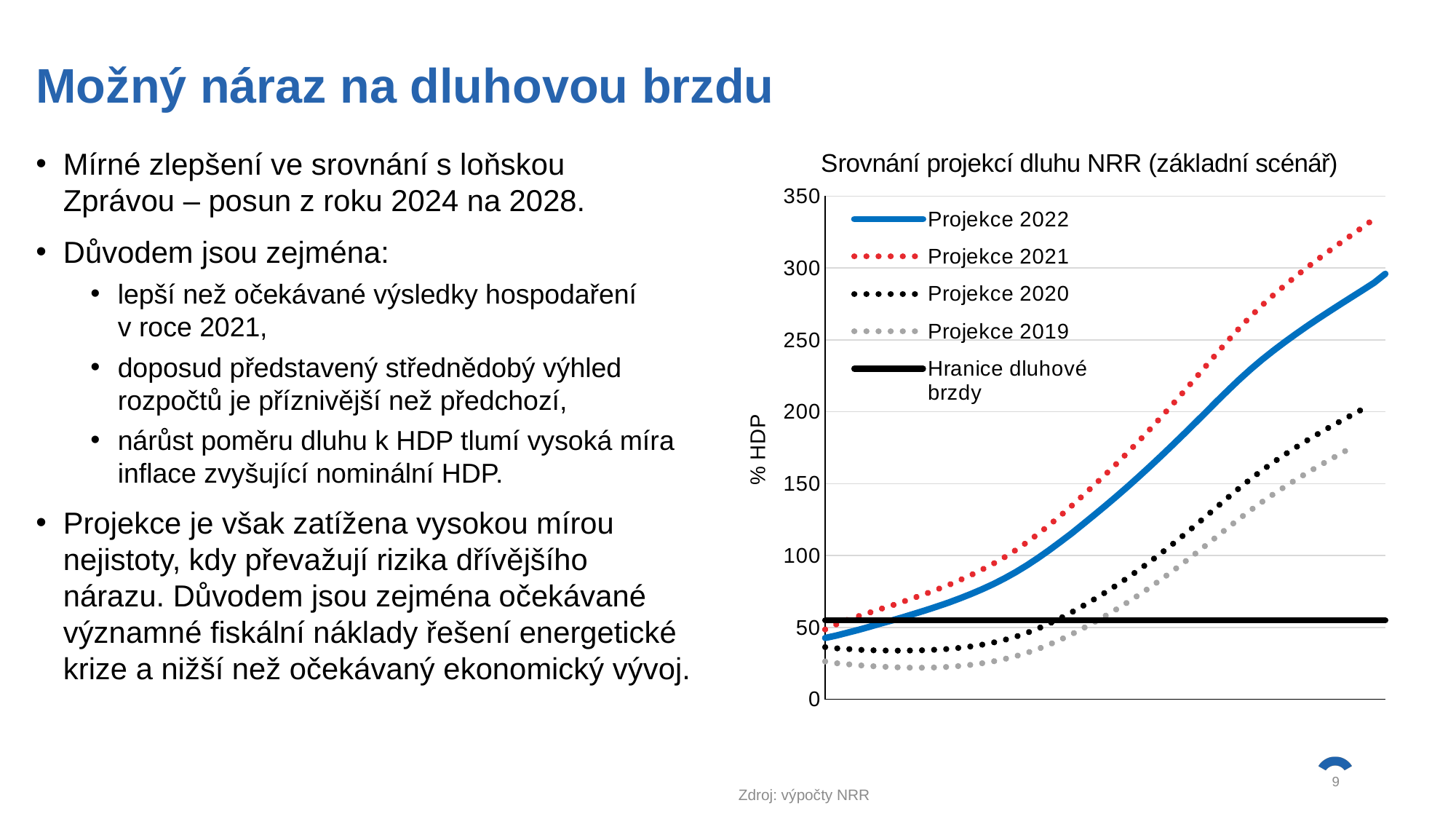
Is the starting value of Projekce 2020 at the left of the chart greater or less than 50? less How many series does the chart legend list? 5 What is the label of the vertical axis of the chart? % HDP Is the starting value of Projekce 2019 at the left of the chart greater or less than 50? less Is the final value of Projekce 2019 greater or less than 150? greater Does the Projekce 2022 series rise or fall along the x axis? rise At the right end of the chart, which is larger: Projekce 2022 or Projekce 2020? Projekce 2022 What kind of chart is shown on the slide? line chart What is the title of the chart? Srovnání projekcí dluhu NRR (základní scénář) Which projection series reaches the highest value at the right end of the chart? Projekce 2021 Which projection series ends at the lowest value at the right end of the chart? Projekce 2019